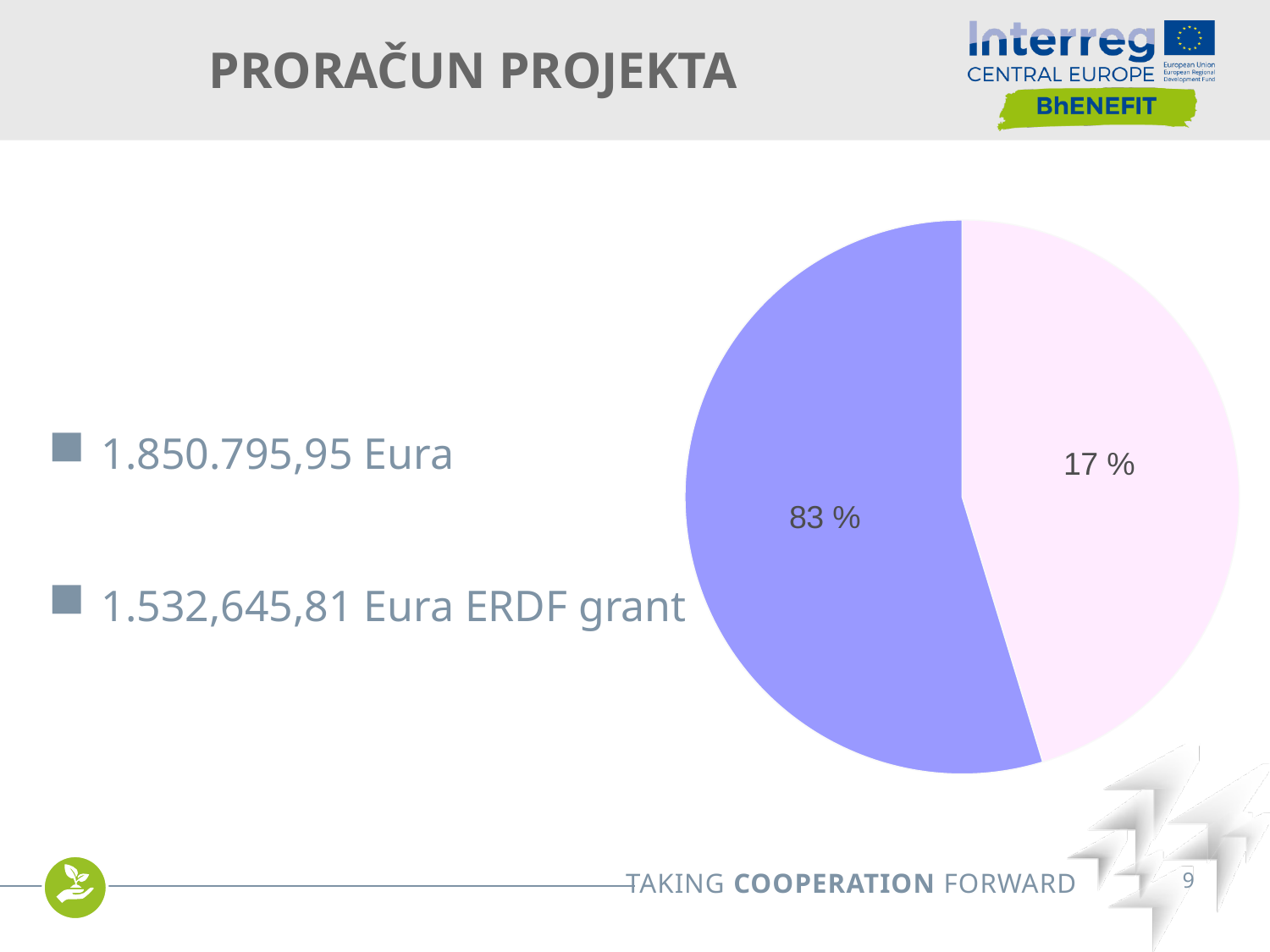
Is the purple slice greater or less than 50 % of the pie? greater What share of the pie does the light pink slice represent? 17 % How many slices does the pie chart have? 2 What is the share of the smallest slice of the pie chart? 17 % What is the difference in percentage points between the two slices of the pie chart? 66 Does the pie chart have a legend? No Which slice is larger, the purple one or the light pink one? the purple one What share of the pie does the purple slice represent? 83 % What kind of chart is shown on the slide? pie chart What is the share of the largest slice of the pie chart? 83 % What do the two slice percentages of the pie chart add up to? 100 %